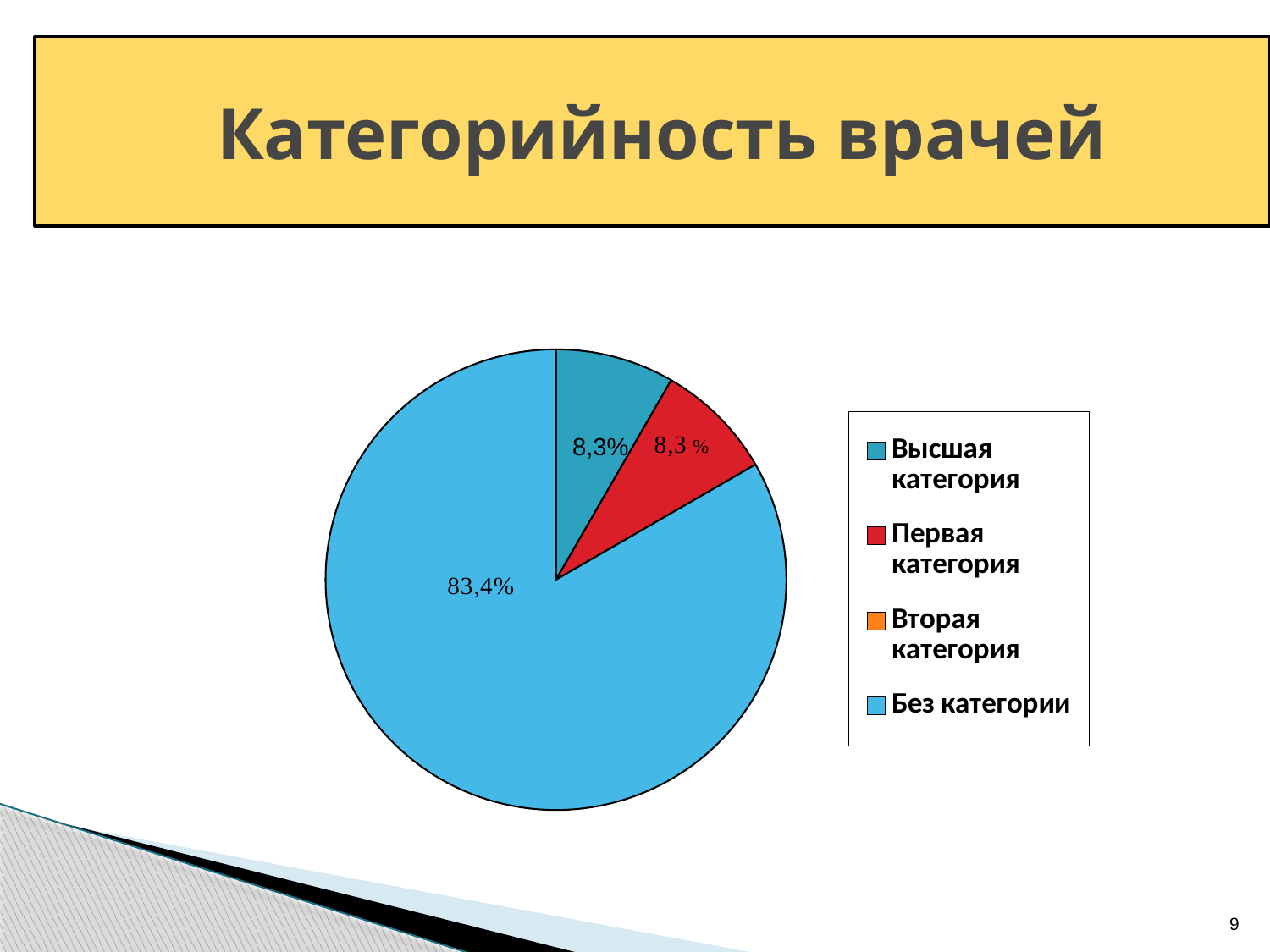
What share of the pie does "Без категории" have? 83,4% How many entries does the legend list? 4 What is the difference between the share for "Без категории" and the share for "Высшая категория"? 75,1% What share of the pie does "Высшая категория" have? 8,3% Is the share for "Без категории" greater or less than 50%? greater What share of the pie does "Первая категория" have? 8,3 % Which is larger, the slice for "Без категории" or the slice for "Первая категория"? Без категории Which category has the largest slice of the pie? Без категории How many slices with data labels are visible in the pie? 3 What is the title of the chart on the slide? Категорийность врачей What colour is the slice for "Первая категория"? red What type of chart is shown on the slide? pie chart